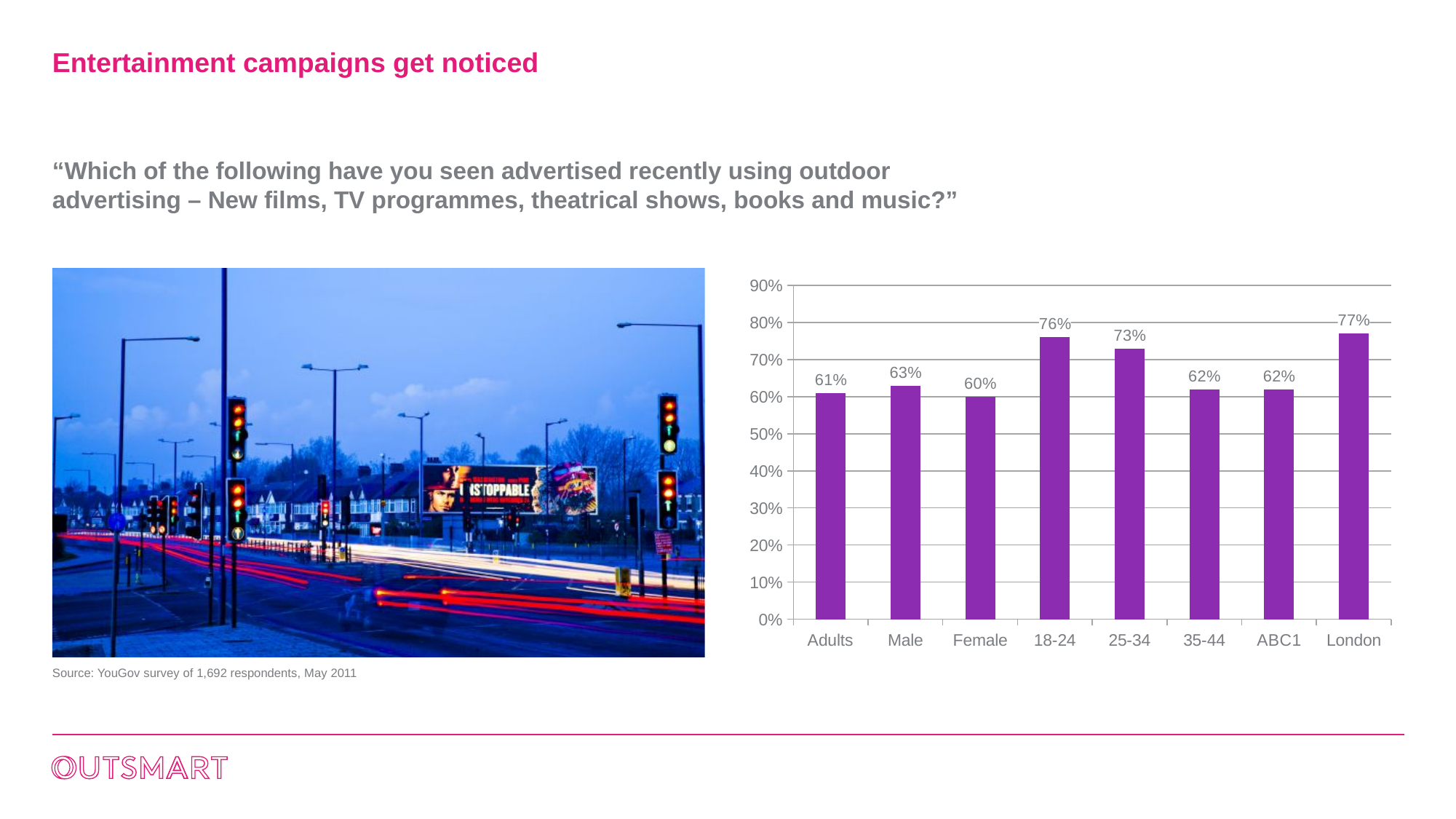
What is the value for London? 77% Which category has the lowest value? Female What is the value for Female? 60% What is the value for 25-34? 73% What colour are the bars in the chart? purple What kind of chart is shown on the slide? bar chart Is the value for 25-34 greater or less than 70%? greater How many categories are shown on the x axis? 8 Which is larger, the value for Male or the value for Female? Male What is the value for Adults? 61% What is the difference between the values for 18-24 and Adults? 15% Which category has the highest value? London